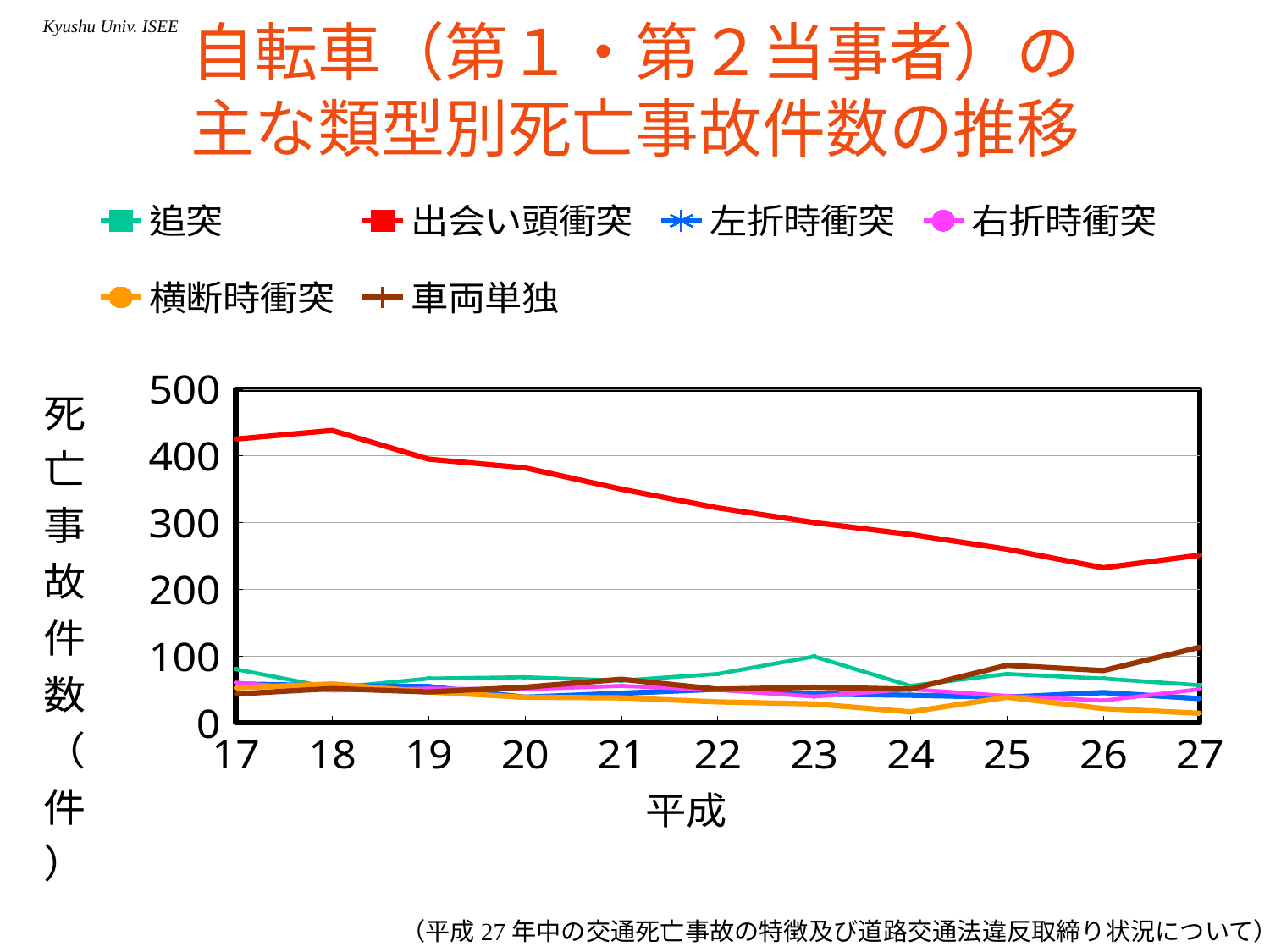
Which series has the highest values across the whole chart? 出会い頭衝突 Is the value for 出会い頭衝突 in 平成26 greater or less than 300? less Is the value for 横断時衝突 in 平成27 greater or less than 100? less How many years (points) are shown along the x axis? 11 What is the title of the chart? 自転車（第１・第２当事者）の主な類型別死亡事故件数の推移 How many series does the legend list? 6 Is the value for 出会い頭衝突 in 平成17 greater or less than 400? greater Which is larger in 平成27, 出会い頭衝突 or 車両単独? 出会い頭衝突 Which series has the lowest value in 平成27? 横断時衝突 What kind of chart is shown on the slide? line chart Does the value for 出会い頭衝突 rise or fall from 平成17 to 平成27? fall What is the label of the x axis? 平成